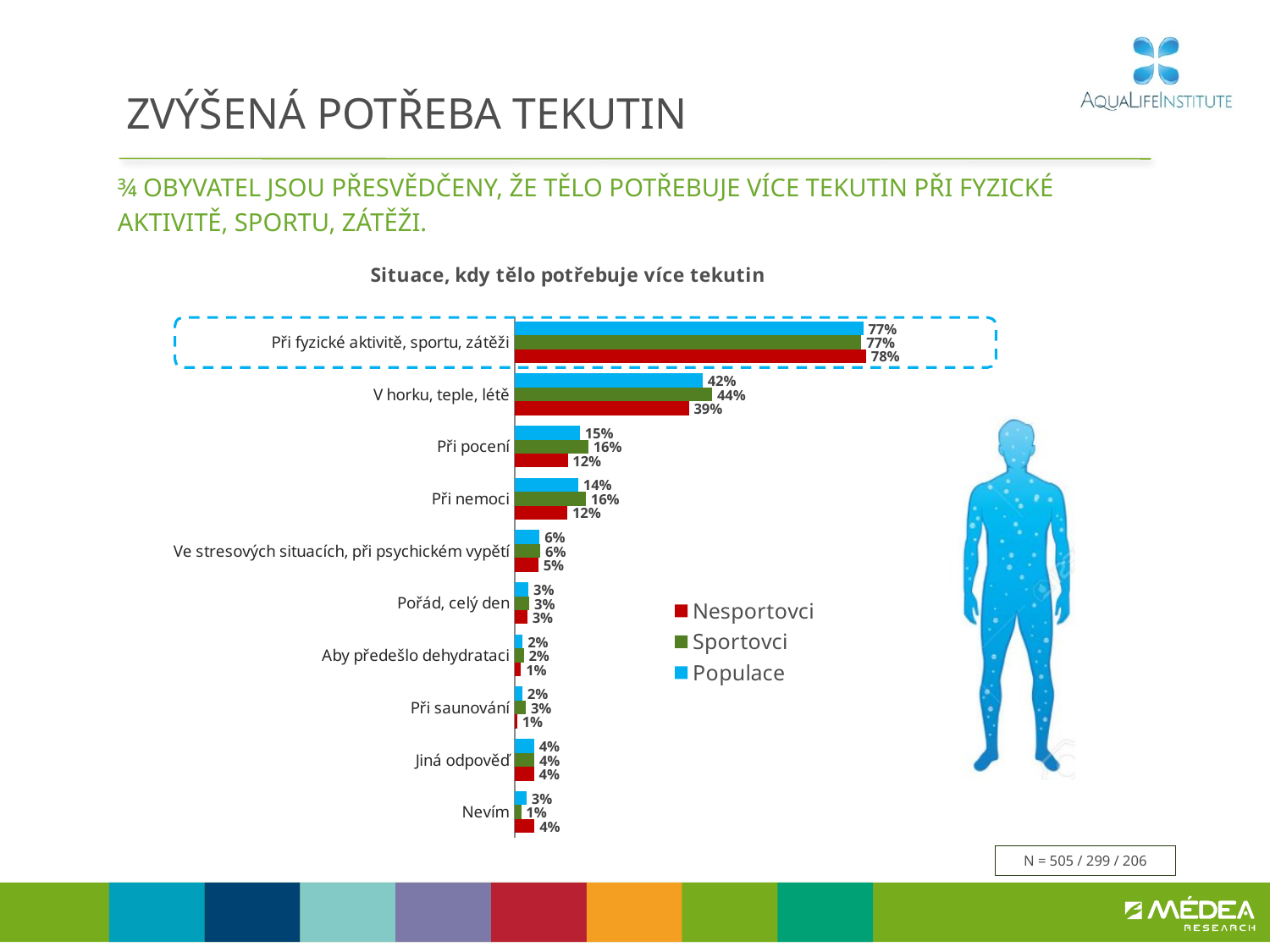
What is the difference between the Sportovci and Nesportovci values in the category 'V horku, teple, létě'? 5% What is the value for Populace in the category 'Při fyzické aktivitě, sportu, zátěži'? 77% Which category has the highest value for Sportovci? Při fyzické aktivitě, sportu, zátěži Which colour represents the Populace series in the chart? blue What is the value for Nesportovci in the category 'V horku, teple, létě'? 39% How many categories are shown in the chart? 10 How many series does the chart legend list? 3 What is the value for Nesportovci in the category 'Nevím'? 4% In the category 'Při pocení', which is larger: the value for Sportovci or for Nesportovci? Sportovci What type of chart is shown on the slide? bar chart What is the title of the chart? Situace, kdy tělo potřebuje více tekutin What is the value for Sportovci in the category 'Při nemoci'? 16%